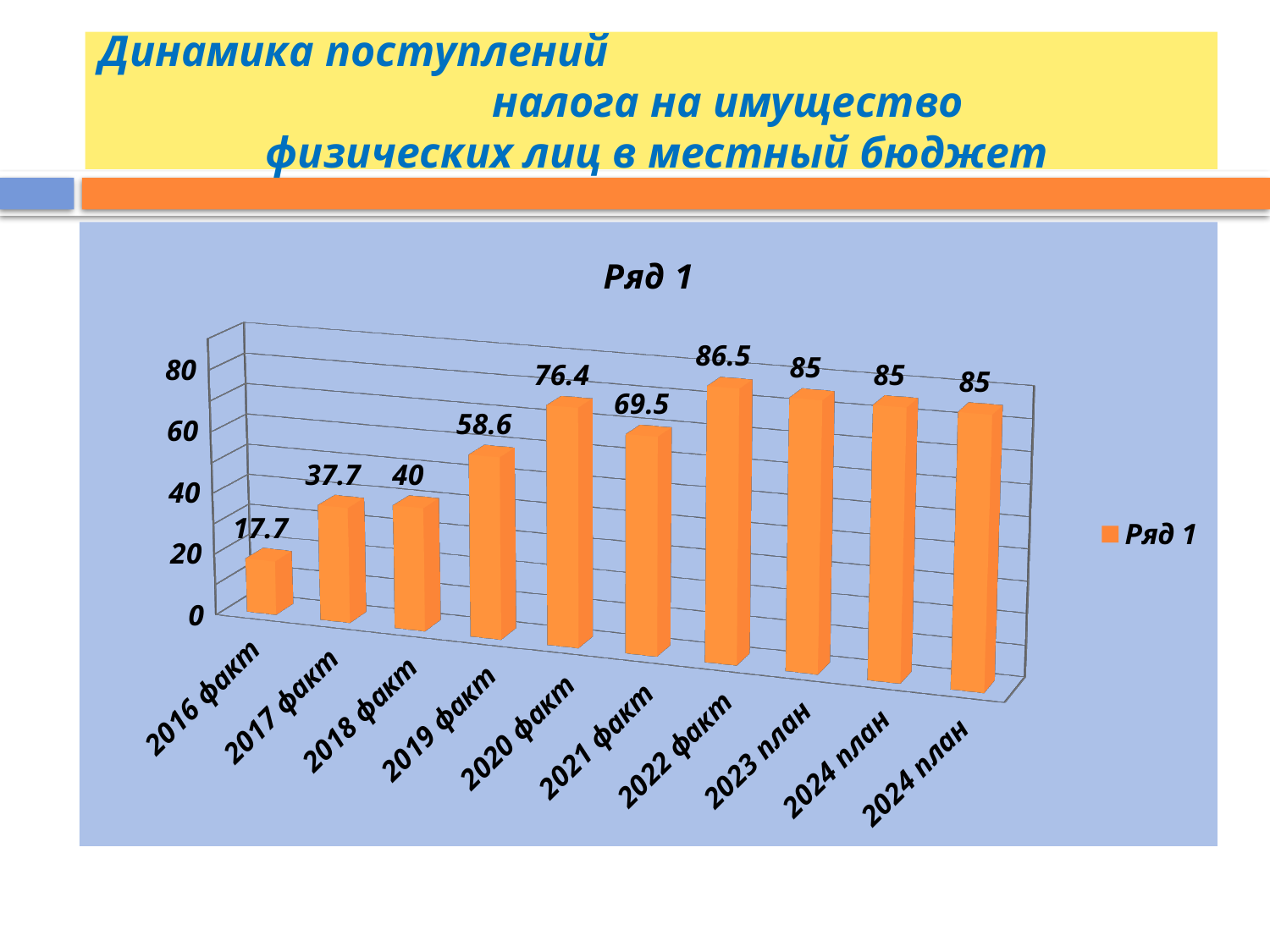
What is the value for 2019 факт? 58.6 How many bars are plotted in the chart? 10 Which category has the highest value? 2022 факт What is the difference between the values for 2020 факт and 2021 факт? 6.9 What is the value for 2022 факт? 86.5 Which category has the lowest value? 2016 факт Which is larger, the value for 2017 факт or the value for 2018 факт? 2018 факт How many series does the legend list? 1 What is the value for 2023 план? 85 What is the value for 2016 факт? 17.7 What is the title shown above the chart? Ряд 1 What kind of chart is shown on the slide? Bar chart